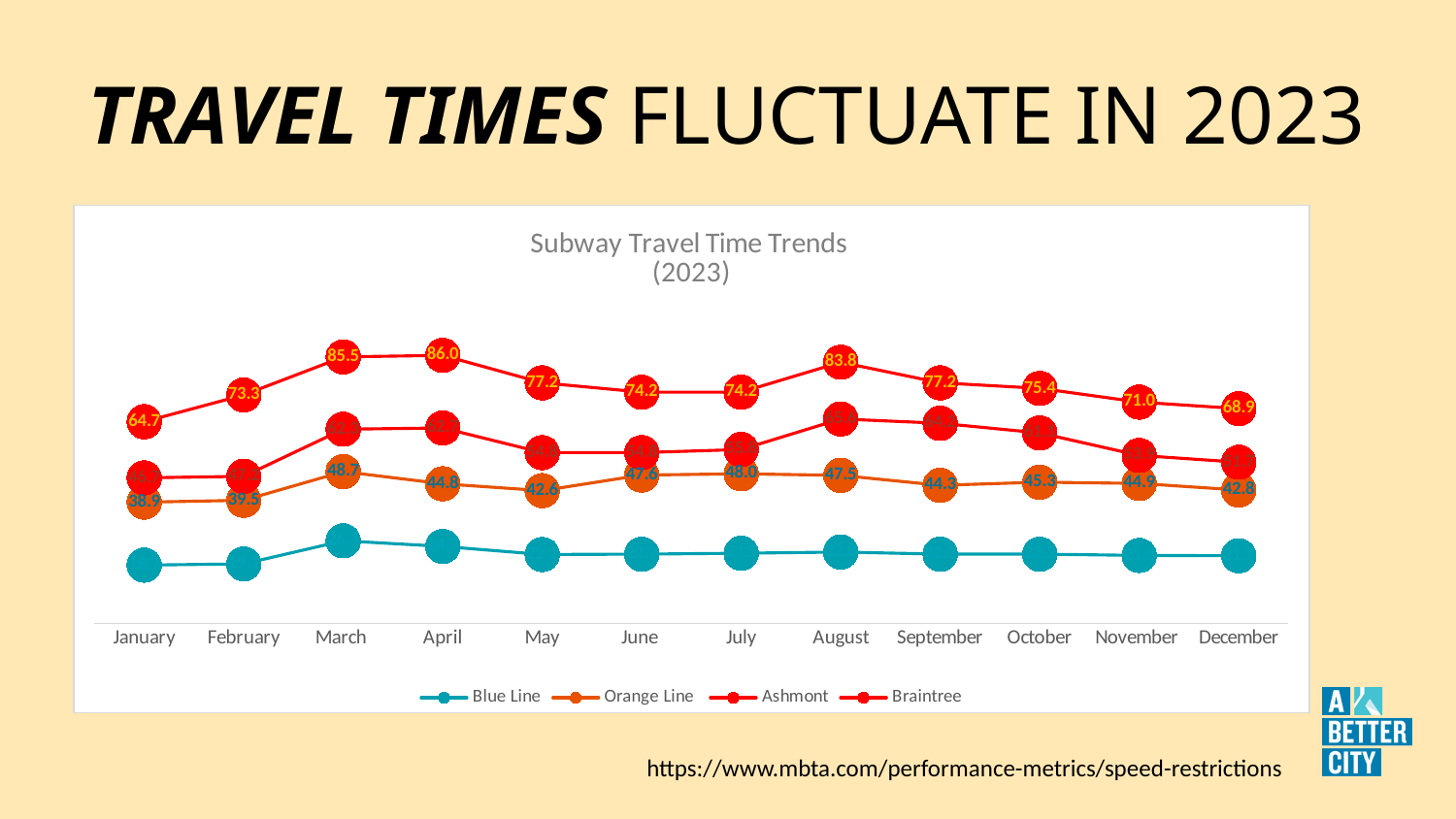
In which month is the Braintree value highest? April Which is larger, the Orange Line value for June or for May? June How many months are plotted on the x axis? 12 How many series does the legend list? 4 In which month is the Orange Line value highest? March Does the Braintree line rise or fall from January to April? Rise In which month is the Orange Line value lowest? January What is the Braintree value for March? 85.5 What is the Orange Line value for December? 42.8 In which month is the Braintree value lowest? January What is the difference between the Braintree values for April and January? 21.3 What kind of chart is shown? Line chart